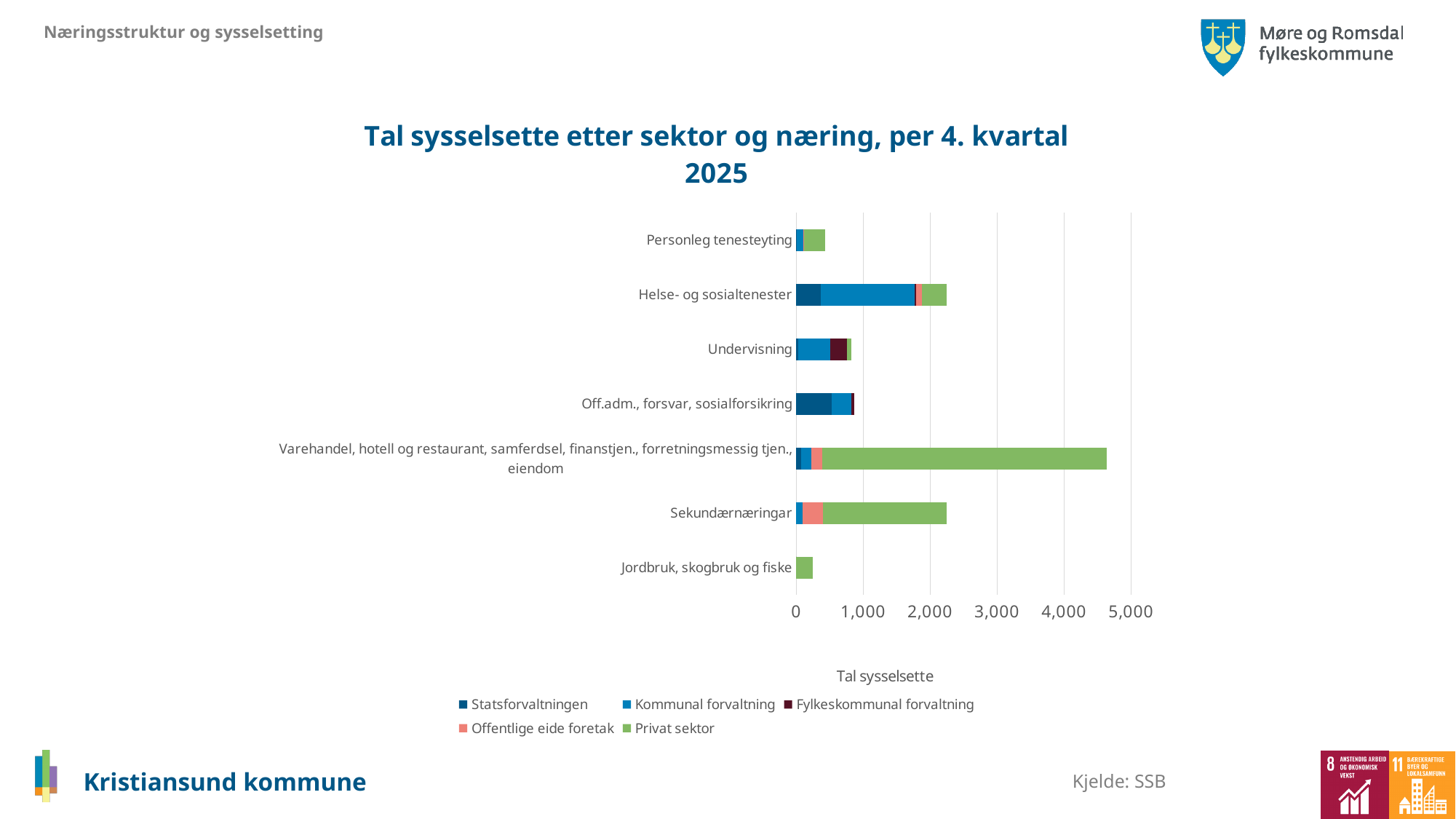
Is the total value for Varehandel, hotell og restaurant, samferdsel, finanstjen., forretningsmessig tjen., eiendom greater or less than 4,000? greater Is the total value for Undervisning greater or less than 1,000? less What kind of chart is shown on the slide? Stacked bar chart Which has the larger total bar: Helse- og sosialtenester or Varehandel, hotell og restaurant, samferdsel, finanstjen., forretningsmessig tjen., eiendom? Varehandel, hotell og restaurant, samferdsel, finanstjen., forretningsmessig tjen., eiendom Is the total value for Helse- og sosialtenester greater or less than 2,000? greater Which category has the longest total bar? Varehandel, hotell og restaurant, samferdsel, finanstjen., forretningsmessig tjen., eiendom Which category has the shortest total bar? Jordbruk, skogbruk og fiske What is the title of the chart? Tal sysselsette etter sektor og næring, per 4. kvartal 2025 What is the label on the x axis of the chart? Tal sysselsette How many categories (næringar) are plotted on the y axis of the chart? 7 How many series does the legend list? 5